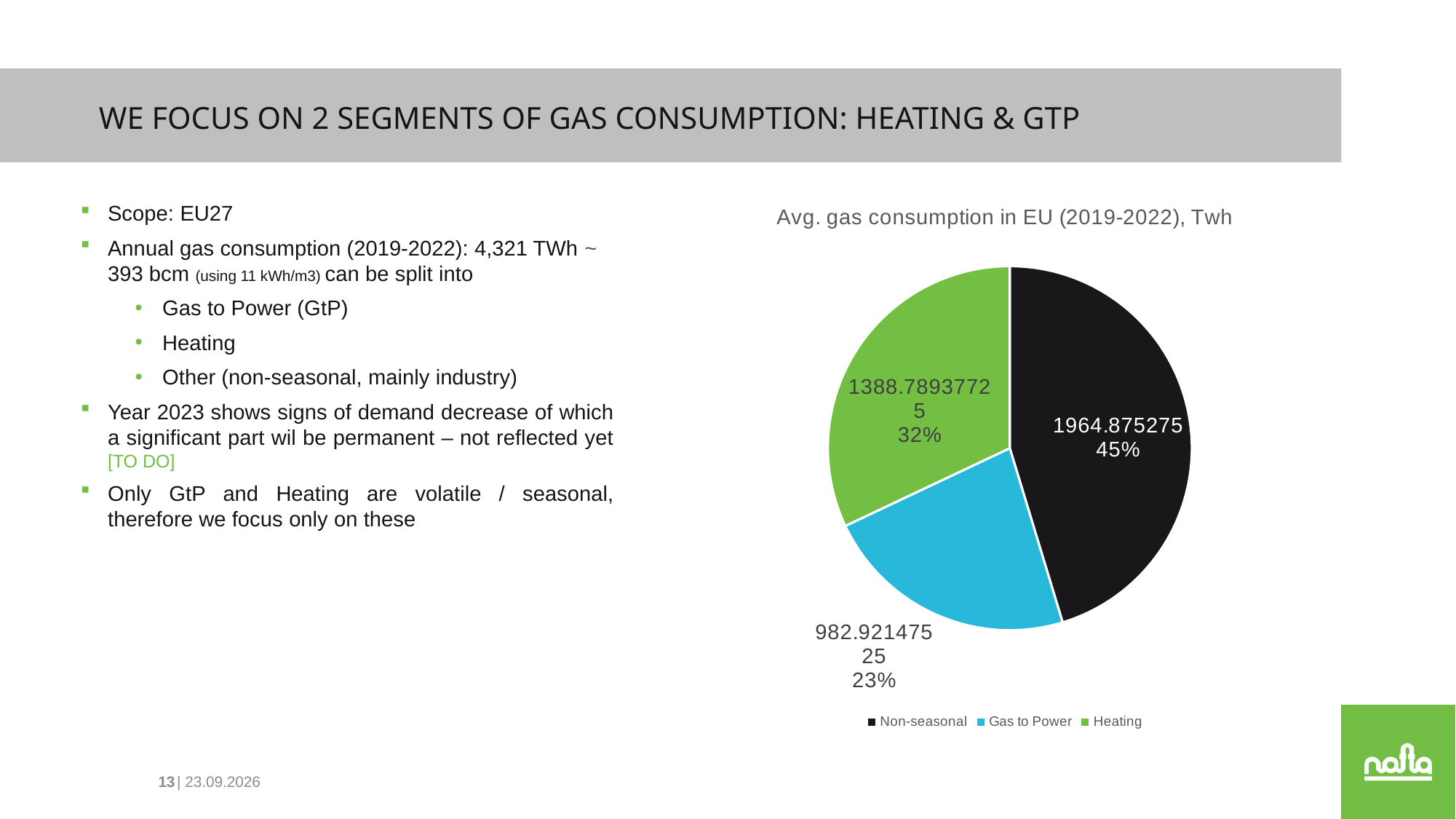
What is the value shown for the Non-seasonal slice? 1964.875275 Which segment has the largest share of the pie? Non-seasonal What kind of chart is shown on the slide? pie chart What percentage share of the pie does Heating have? 32% What is the value shown for the Heating slice? 1388.78937725 What is the title of the chart? Avg. gas consumption in EU (2019-2022), Twh Which segment has the smallest share of the pie? Gas to Power How many entries does the chart legend list? 3 How many slices does the pie chart have? 3 What percentage share of the pie does Non-seasonal have? 45% Which is larger, the share for Heating or the share for Gas to Power? Heating What percentage share of the pie does Gas to Power have? 23%